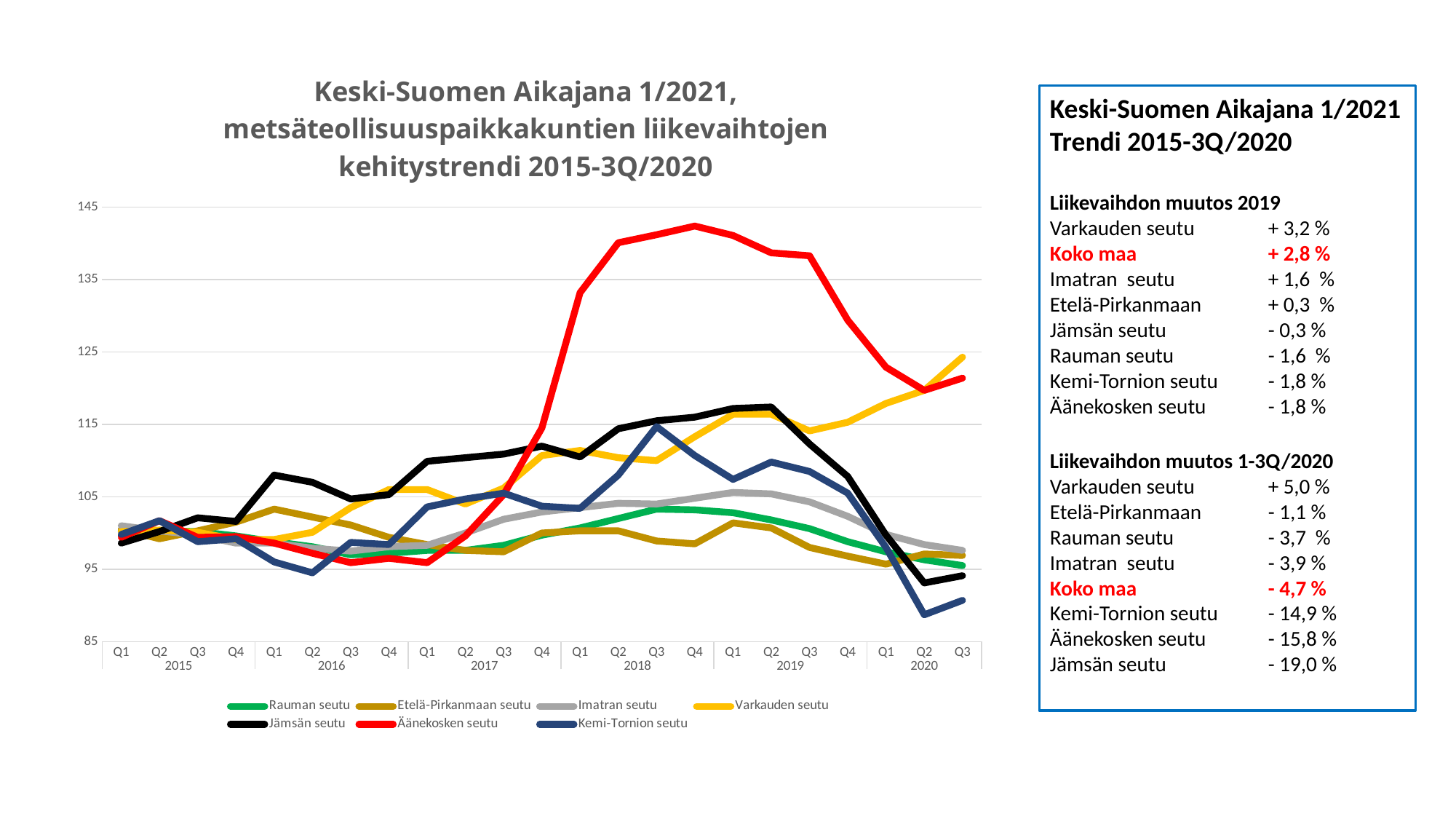
How many series does the chart's legend list? 7 Does the Äänekosken seutu line rise or fall from Q4 2018 to Q4 2019? Fall How many quarterly points are plotted along the x axis of the chart? 23 What kind of chart is shown on the slide? Line chart At Q1 2019, which is higher: Jämsän seutu or Rauman seutu? Jämsän seutu Is the value for Äänekosken seutu at Q4 2018 greater or less than 135? greater Which series has the highest value at Q3 2020? Varkauden seutu Which series has the lowest value at Q2 2020? Kemi-Tornion seutu Is the value for Varkauden seutu at Q3 2020 greater or less than 115? greater Is the value for Kemi-Tornion seutu at Q2 2020 greater or less than 95? less Which series has the highest value at Q4 2018? Äänekosken seutu What colour is the Äänekosken seutu line in the chart? Red